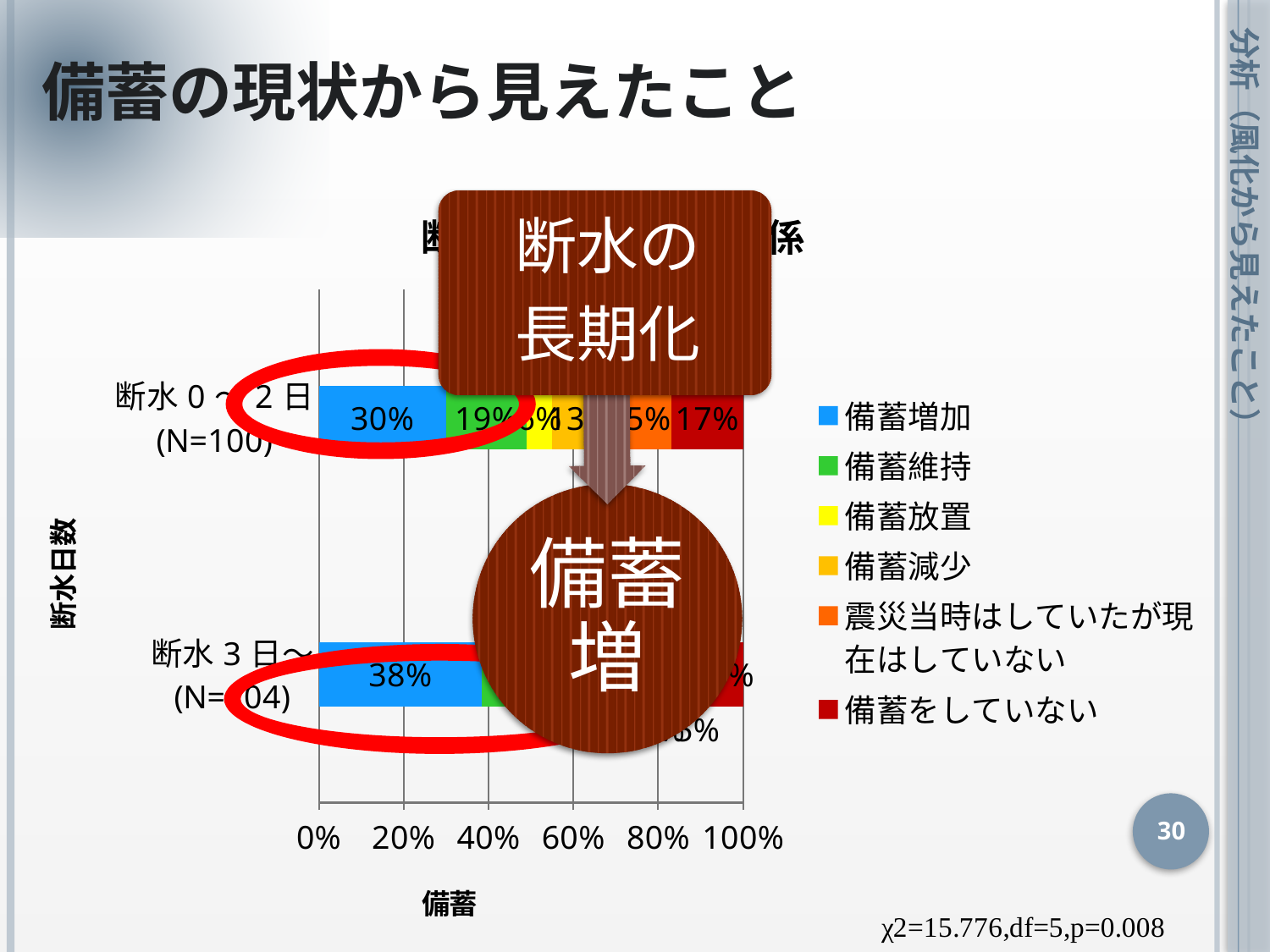
What is the value of 備蓄をしていない for 断水０～２日 (N=100)? 17% How many series does the legend list? 6 What is the value of 備蓄維持 for 断水０～２日 (N=100)? 19% What is the value of 備蓄増加 for 断水０～２日 (N=100)? 30% What colour represents 備蓄増加 in the legend? Blue How many categories (bars) are shown on the y axis? 2 What is the difference in 備蓄増加 between 断水３日～ (38%) and 断水０～２日 (30%)? 8 percentage points What kind of chart is shown on the slide? Stacked bar chart What is the value of 備蓄増加 for 断水３日～ (N=104)? 38% What is the title of the x axis? 備蓄 Which category has the larger value for 備蓄増加, 断水０～２日 or 断水３日～? 断水３日～ For 断水０～２日, what is the difference between 備蓄増加 (30%) and 備蓄維持 (19%)? 11 percentage points